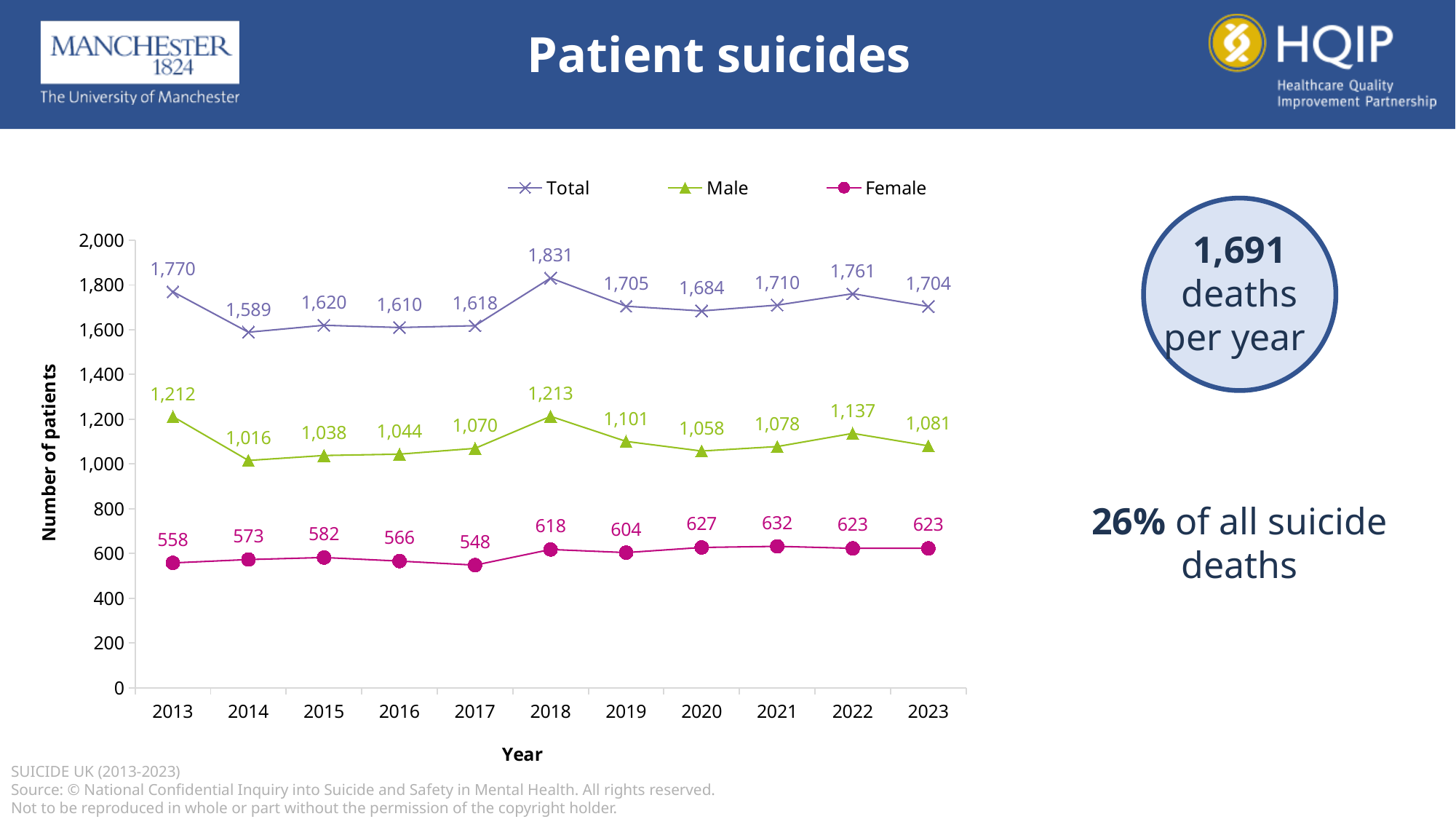
Which is larger, the Total value for 2013 or the Total value for 2022? 2013 What kind of chart is shown on the slide? Line chart How many years are shown on the x axis? 11 What is the Female value for 2021? 632 What is the Male value for 2014? 1,016 What is the difference between the Male and Female values in 2023? 458 What is the Total value for 2018? 1,831 What is the label of the y axis? Number of patients Does the Female series rise or fall from 2013 to 2023? Rise In which year is the Total series highest? 2018 How many series does the legend list? 3 In which year is the Female series lowest? 2017